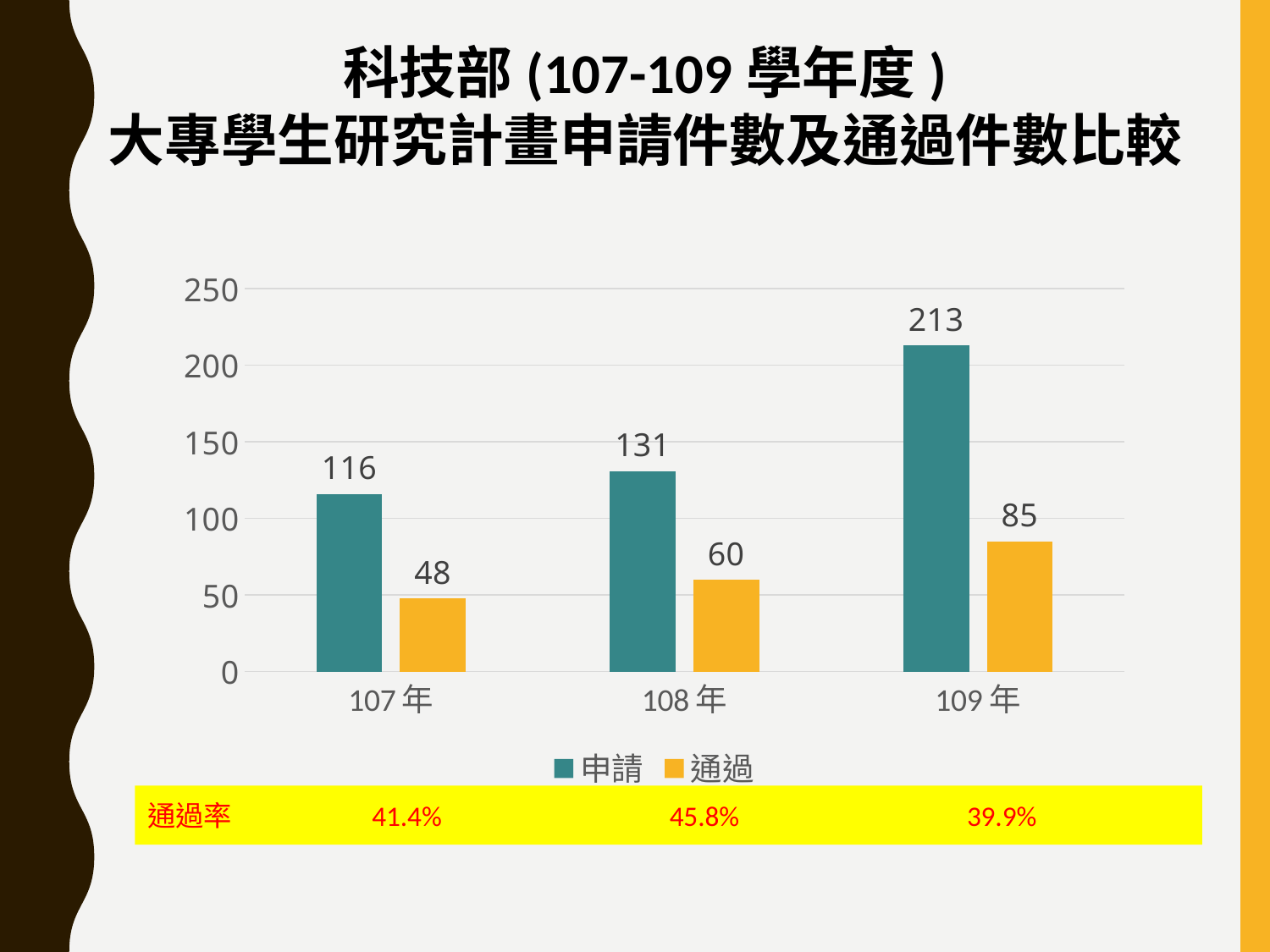
Which year has the highest 申請 value? 109 年 What is the value of 通過 for 109 年? 85 Does the 申請 value rise or fall from 107 年 to 109 年? Rise Which year has the lowest 通過 value? 107 年 What is the difference in 申請 between 108 年 and 107 年? 15 Which is larger: 通過 for 108 年 or 通過 for 107 年? 通過 for 108 年 What is the value of 申請 for 107 年? 116 How many series does the legend list? 2 What is the value of 通過 for 108 年? 60 What kind of chart is shown on the slide? Bar chart How many year categories are shown on the x axis? 3 What is the difference between 申請 and 通過 for 109 年? 128